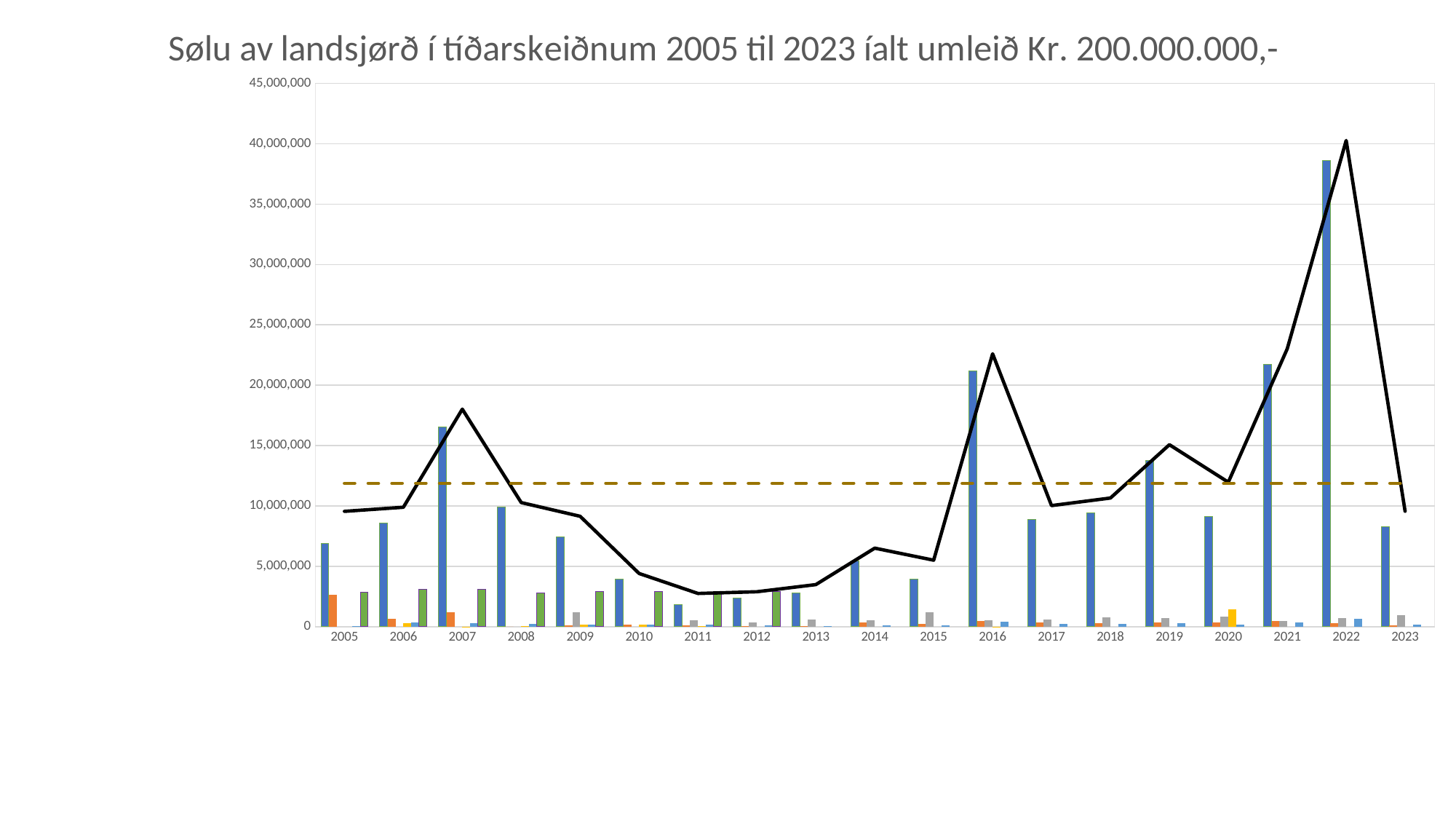
In which year is the tallest blue bar? 2022 What kind of chart is shown on the slide? A combined bar and line chart Does the black line rise or fall from 2007 to 2011? fall Is the blue bar for 2022 greater or less than 35,000,000? greater How many years are shown along the x axis? 19 Which year has the higher black line value, 2016 or 2019? 2016 Is the blue bar for 2016 greater or less than 20,000,000? greater Is the black line value for 2011 greater or less than 5,000,000? less In which year does the black line reach its highest point? 2022 What is the title of the chart? Sølu av landsjørð í tíðarskeiðnum 2005 til 2023 íalt umleið Kr. 200.000.000,-